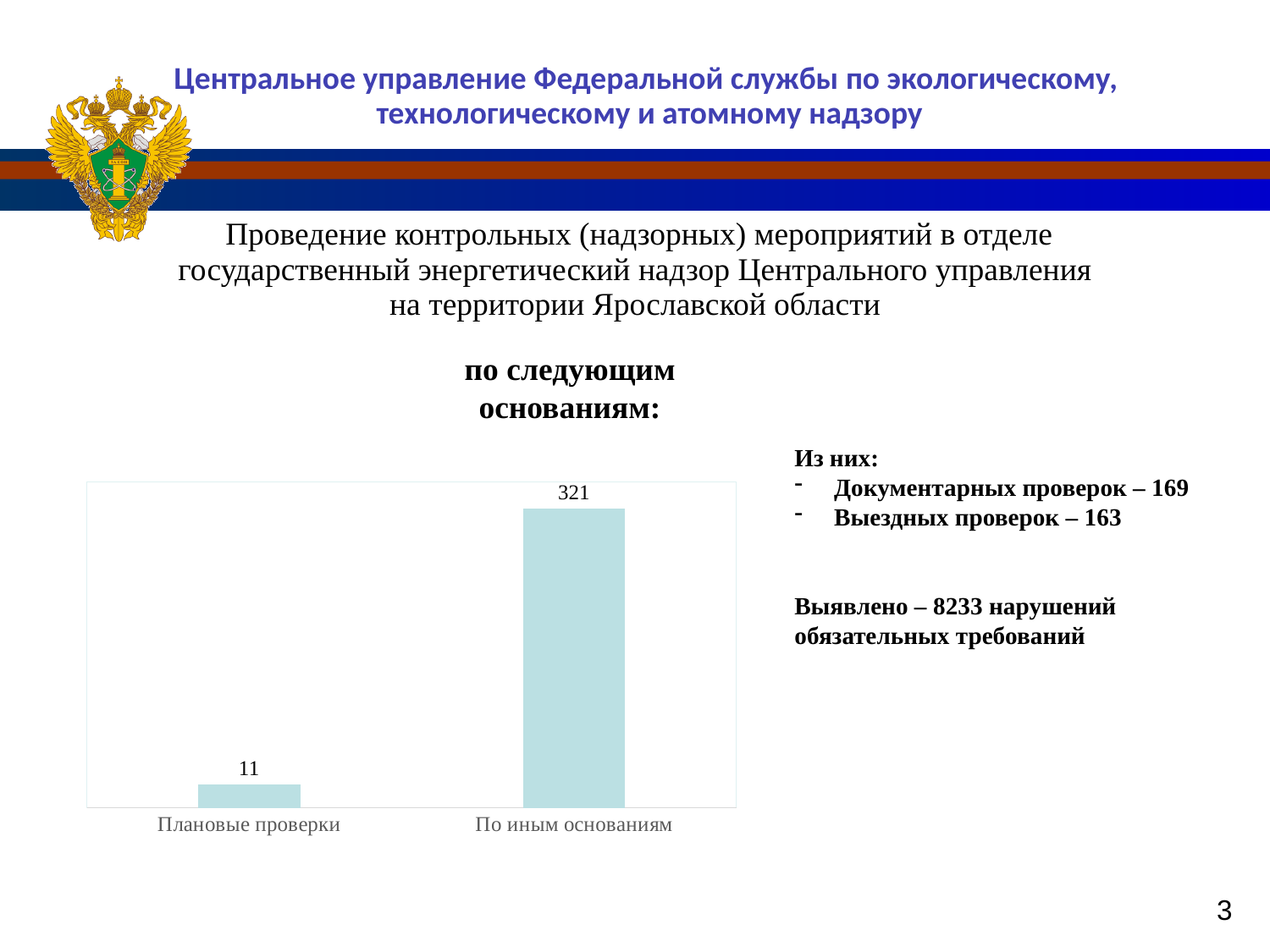
Which category has the lowest value? Плановые проверки What is the value for Плановые проверки? 11 What is the value for По иным основаниям? 321 How many categories are shown in the chart? 2 What is the difference between the values for По иным основаниям and Плановые проверки? 310 Do the values rise or fall from left to right along the x axis? rise What kind of chart is shown on the slide? bar chart Which category has the highest value? По иным основаниям Which is larger, the value for Плановые проверки or the value for По иным основаниям? По иным основаниям What is the title shown above the chart? по следующим основаниям: What is the total of the two bars in the chart? 332